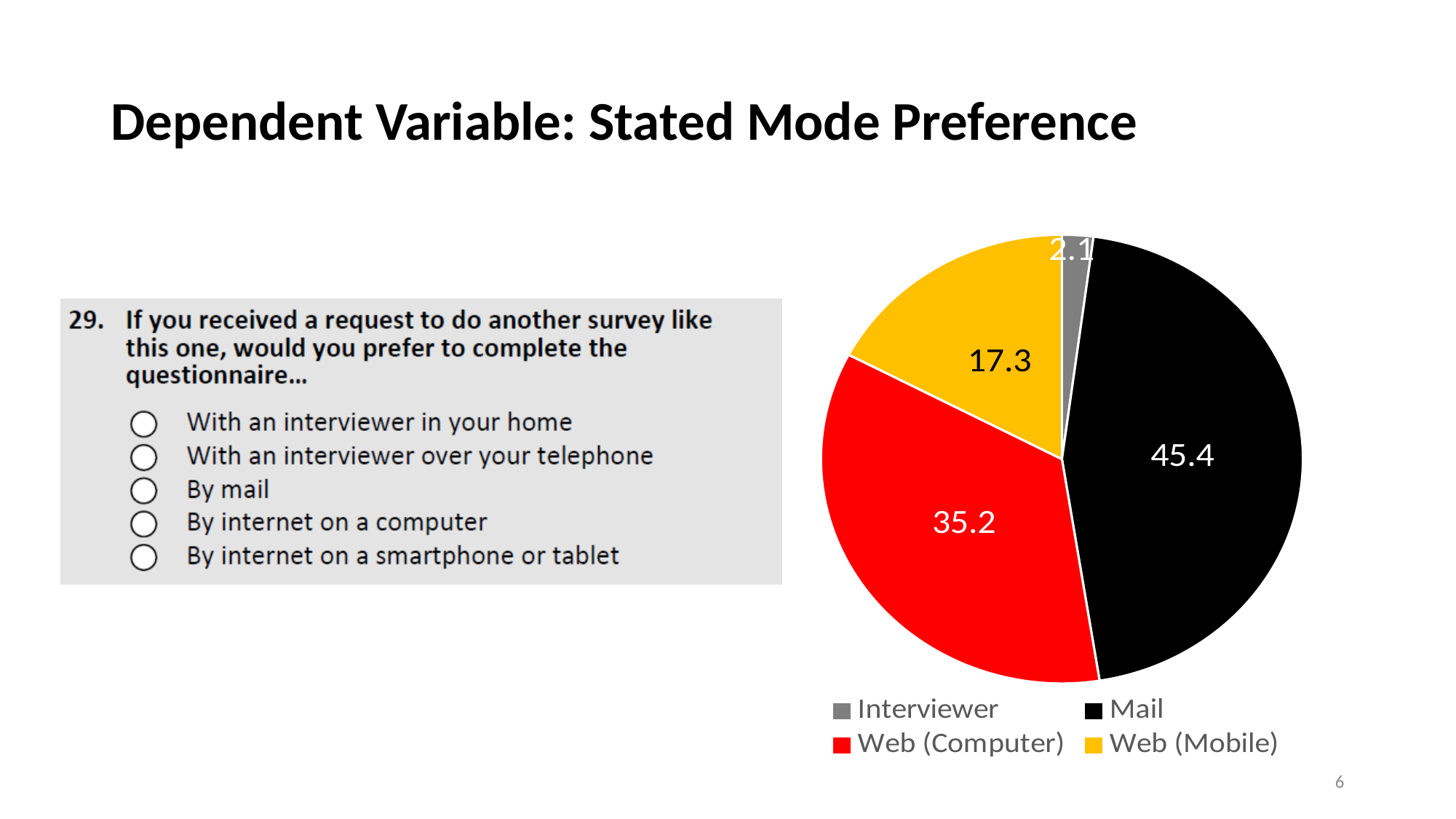
What is the value for Web (Mobile) in the pie chart? 17.3 What kind of chart is shown on the slide? pie chart How many entries does the legend list? 4 What is the value for Interviewer in the pie chart? 2.1 What is the value for Mail in the pie chart? 45.4 Which category has the largest slice of the pie chart? Mail Which is larger, the value for Web (Computer) or the value for Web (Mobile)? Web (Computer) Which category has the smallest slice of the pie chart? Interviewer How many slices does the pie chart have? 4 What colour is the Web (Mobile) slice in the pie chart? yellow What is the value for Web (Computer) in the pie chart? 35.2 What is the difference between the values for Mail and Web (Computer)? 10.2